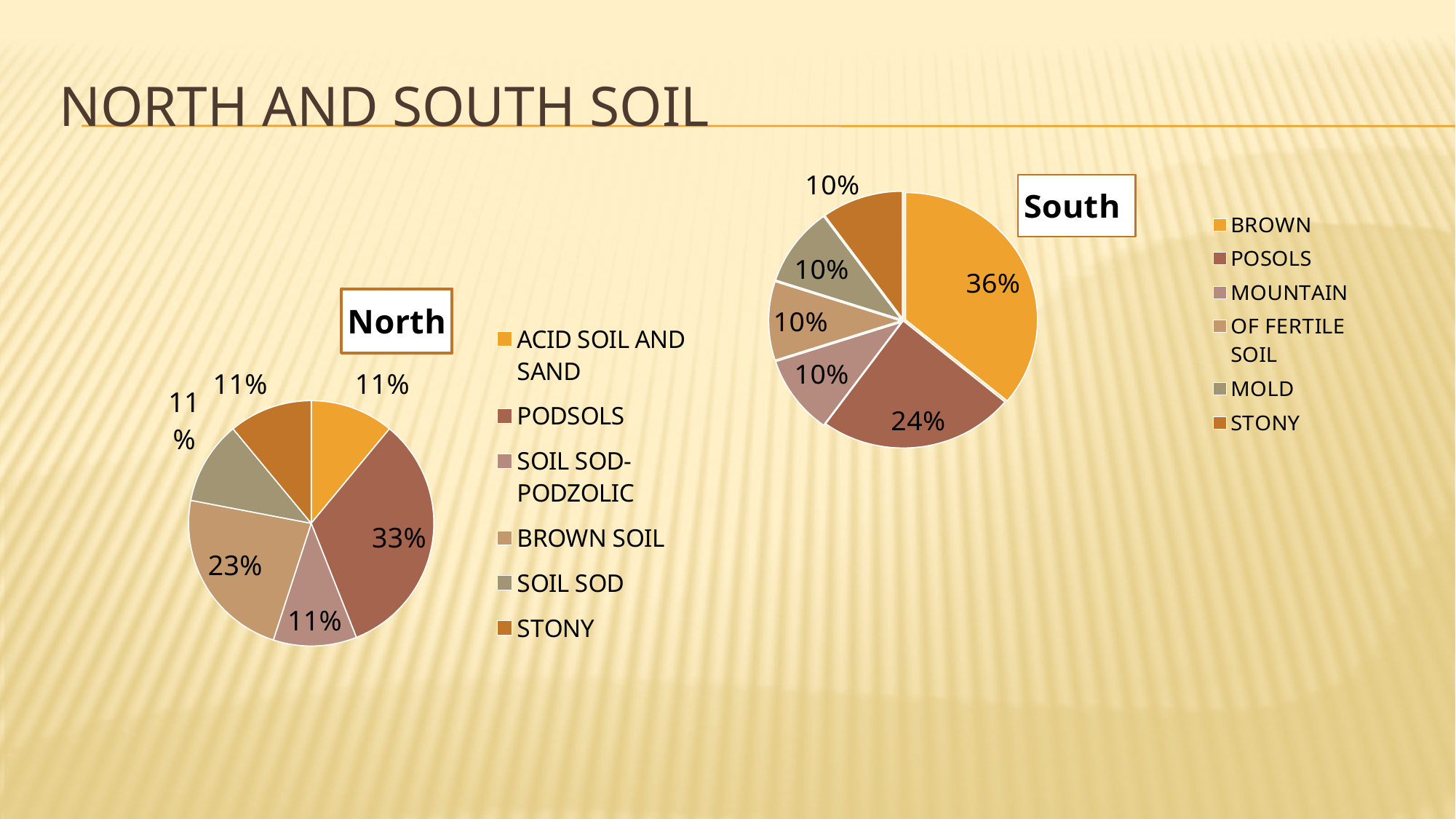
In the South pie chart, what share does BROWN have? 36% In the North pie chart, which category has the largest slice? PODSOLS In the North pie chart, what share does PODSOLS have? 33% In the South pie chart, which category has the largest slice? BROWN In the South pie chart, what share does POSOLS have? 24% In the South pie chart, how many entries does the legend list? 6 In the North pie chart, how many categories are shown? 6 What kind of chart is the North chart? Pie chart In the North pie chart, what is the difference between the PODSOLS share and the BROWN SOIL share? 10% In the South pie chart, what is the difference between the BROWN share and the POSOLS share? 12%